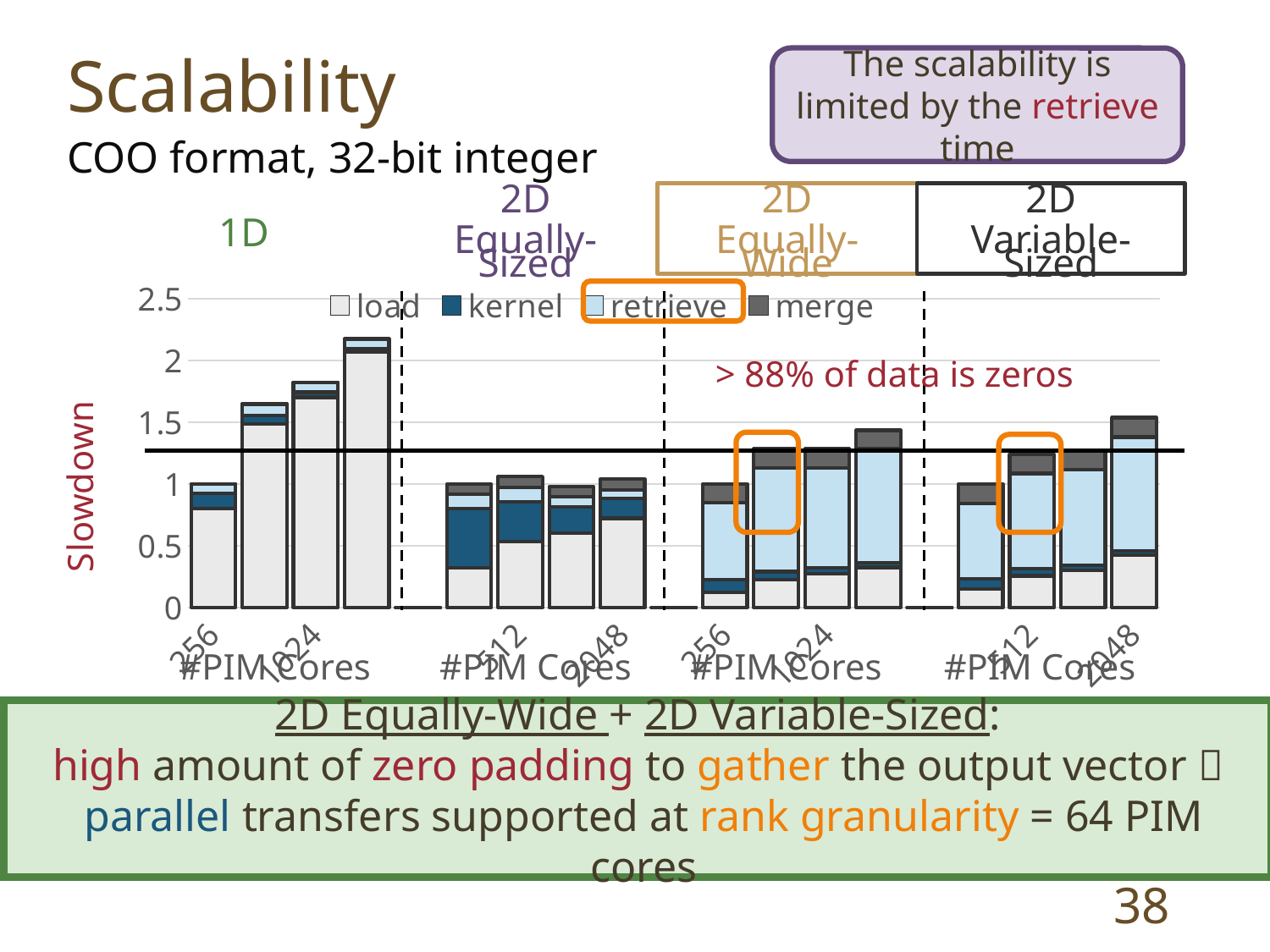
What kind of chart is shown on the slide? stacked bar chart How many series does the chart legend list? 4 Which group contains the tallest bar in the chart? 1D How many bars are plotted in the chart in total? 16 Do the bar heights rise or fall from left to right within the 1D group? rise Is the tallest bar in the 2D Equally-Sized group greater or less than 1.5? less What is the title of the vertical axis of the chart? Slowdown How many groups of bars (partitioning schemes) are shown in the chart? 4 Which is taller: the tallest bar in the 1D group or the tallest bar in the 2D Equally-Sized group? the tallest bar in the 1D group Is the tallest bar in the 1D group greater or less than 2? greater Is the tallest bar in the 2D Equally-Wide group greater or less than 1.5? less What are the series names listed in the chart legend? load, kernel, retrieve, merge